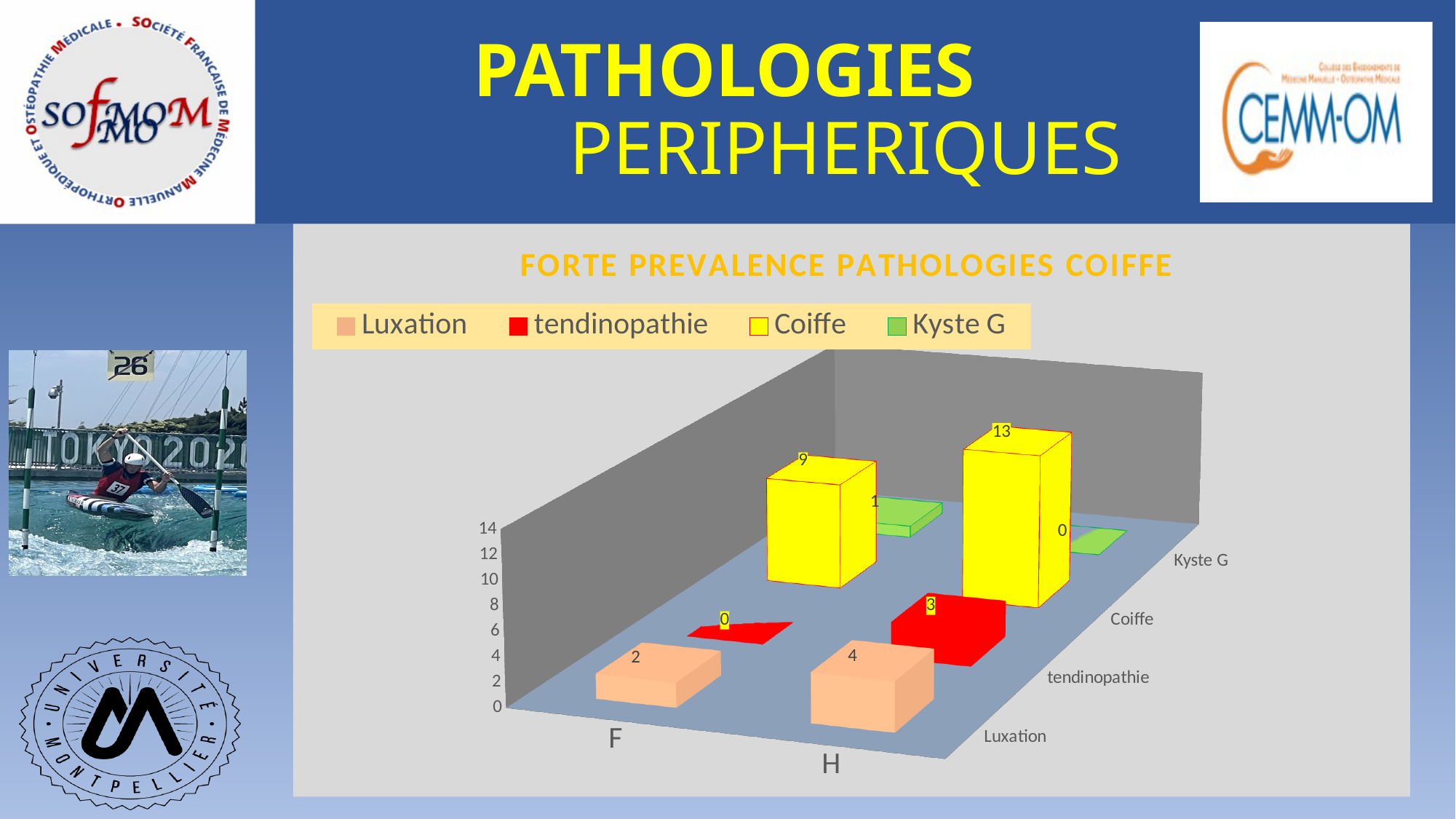
What is the title of the chart? FORTE PREVALENCE PATHOLOGIES COIFFE What kind of chart is shown? bar chart Which is larger, the Luxation value for F or for H? H What is the Coiffe value for H? 13 How many categories are shown on the x axis? 2 What is the Luxation value for H? 4 How many series does the legend list? 4 Which series has the highest value for H? Coiffe What is the Kyste G value for F? 1 What is the tendinopathie value for F? 0 What is the Coiffe value for F? 9 What is the difference between the Coiffe values for H and F? 4